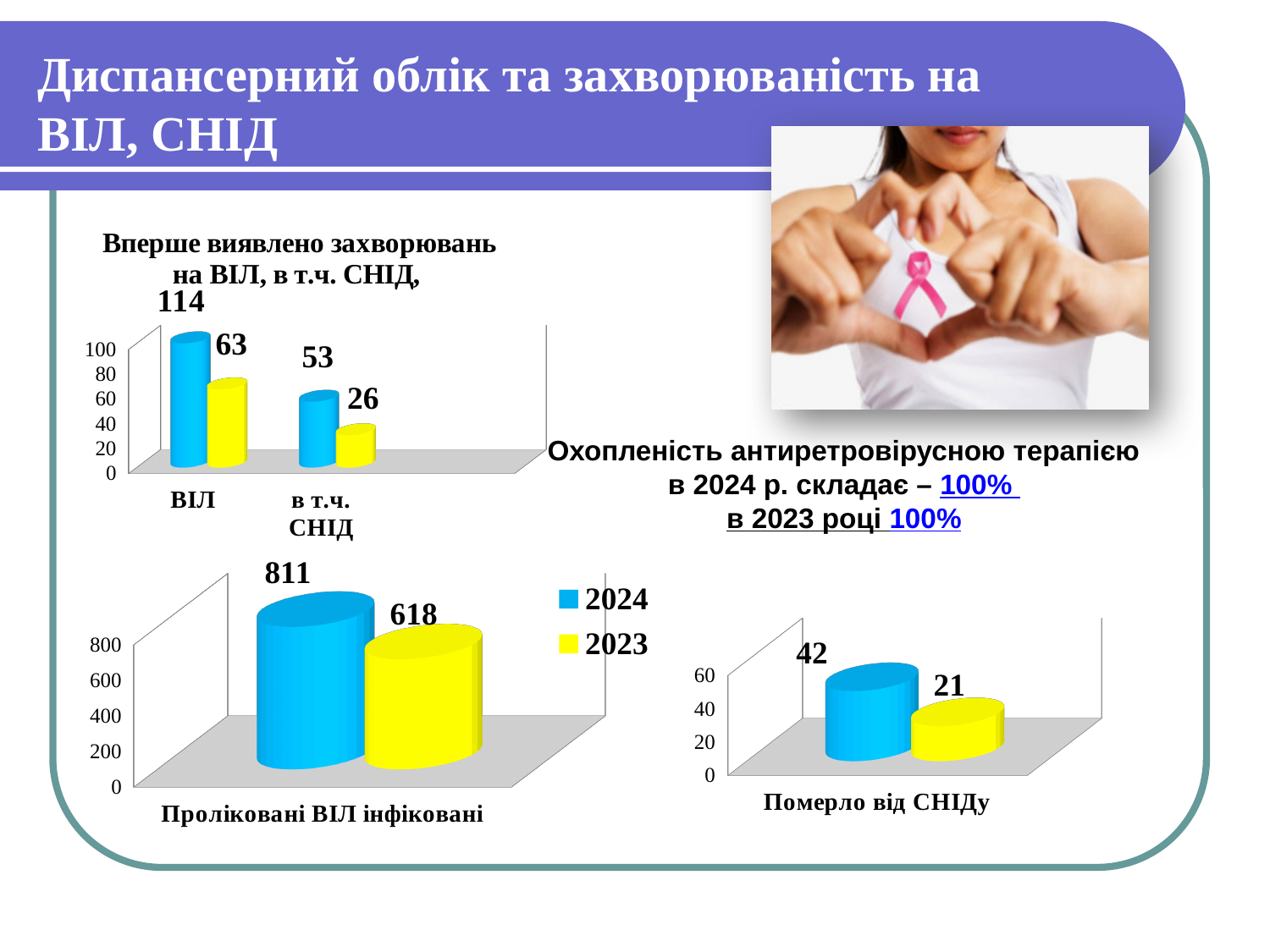
In the chart 'Померло від СНІДу', what is the difference between the 2024 and 2023 values? 21 In the chart 'Померло від СНІДу', which year has the larger value, 2024 or 2023? 2024 In the chart 'Проліковані ВІЛ інфіковані', what is the value for 2023? 618 In the chart 'Вперше виявлено захворювань на ВІЛ, в т.ч. СНІД', what is the 2023 value for в т.ч. СНІД? 26 In the chart 'Вперше виявлено захворювань на ВІЛ, в т.ч. СНІД', which category has the lowest value? в т.ч. СНІД (2023) How many series does the legend on the slide list? 2 In the chart 'Вперше виявлено захворювань на ВІЛ, в т.ч. СНІД', what is the 2024 value for ВІЛ? 114 What kind of chart is 'Проліковані ВІЛ інфіковані'? Bar chart In the chart 'Померло від СНІДу', what is the value for 2024? 42 In the chart 'Вперше виявлено захворювань на ВІЛ, в т.ч. СНІД', what is the difference between the 2024 and 2023 values for ВІЛ? 51 In the chart 'Проліковані ВІЛ інфіковані', what is the value for 2024? 811 In the chart 'Проліковані ВІЛ інфіковані', what is the difference between the 2024 and 2023 values? 193